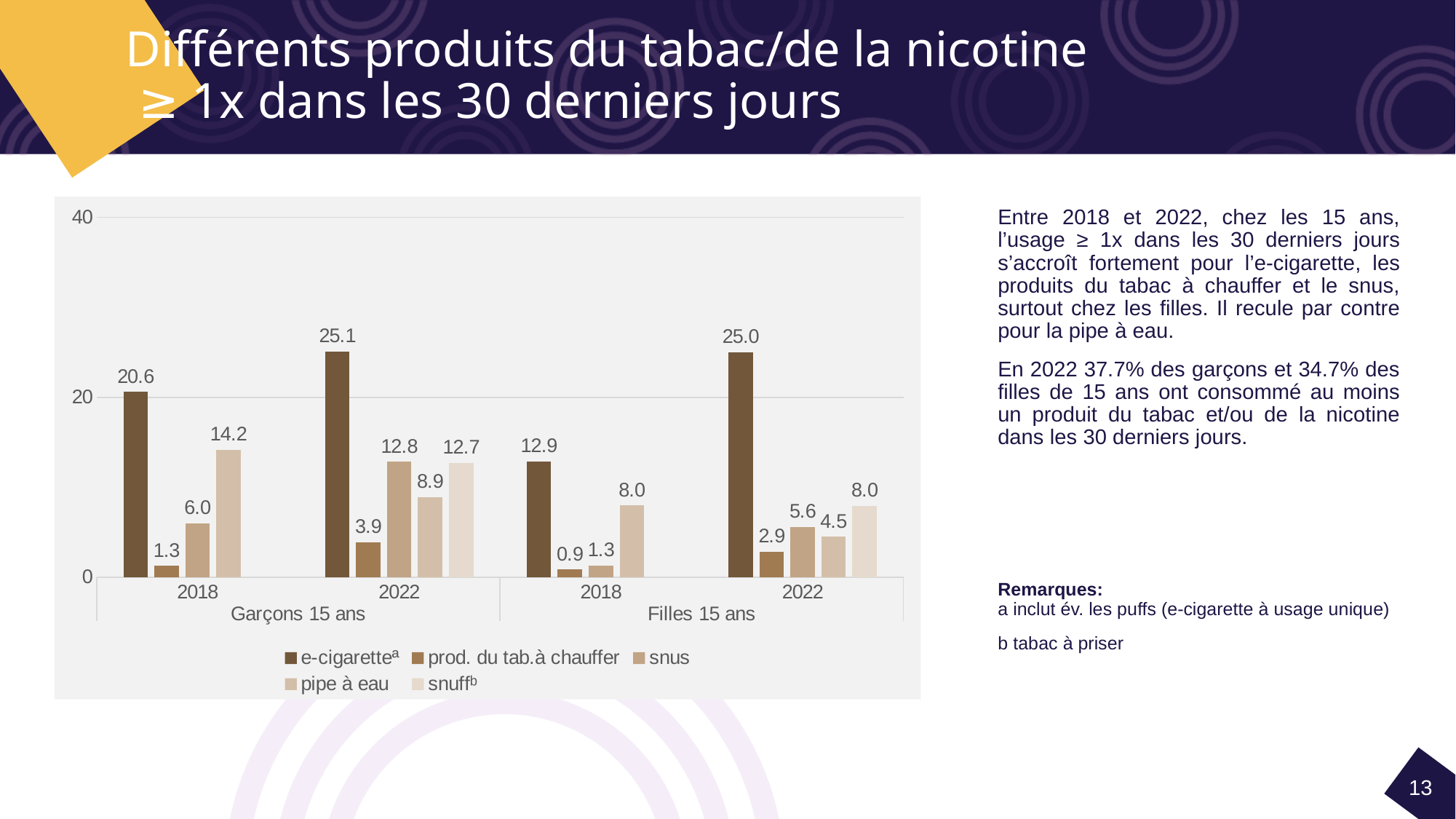
How many series does the legend list? 5 What is the value for e-cigarette among Garçons 15 ans in 2022? 25.1 Which product has the highest value among Garçons 15 ans in 2018? e-cigarette What kind of chart is shown on the slide? bar chart What is the value for snus among Filles 15 ans in 2018? 1.3 What is the value for snuff among Filles 15 ans in 2022? 8.0 What is the difference between the pipe à eau values for Garçons 15 ans in 2018 and 2022? 5.3 Which product has the lowest value among Filles 15 ans in 2018? prod. du tab.à chauffer Does the pipe à eau value for Filles 15 ans rise or fall from 2018 to 2022? fall What is the value for pipe à eau among Garçons 15 ans in 2018? 14.2 By how much did the e-cigarette value for Filles 15 ans increase from 2018 to 2022? 12.1 For Garçons 15 ans in 2022, which is larger: snus or snuff? snus